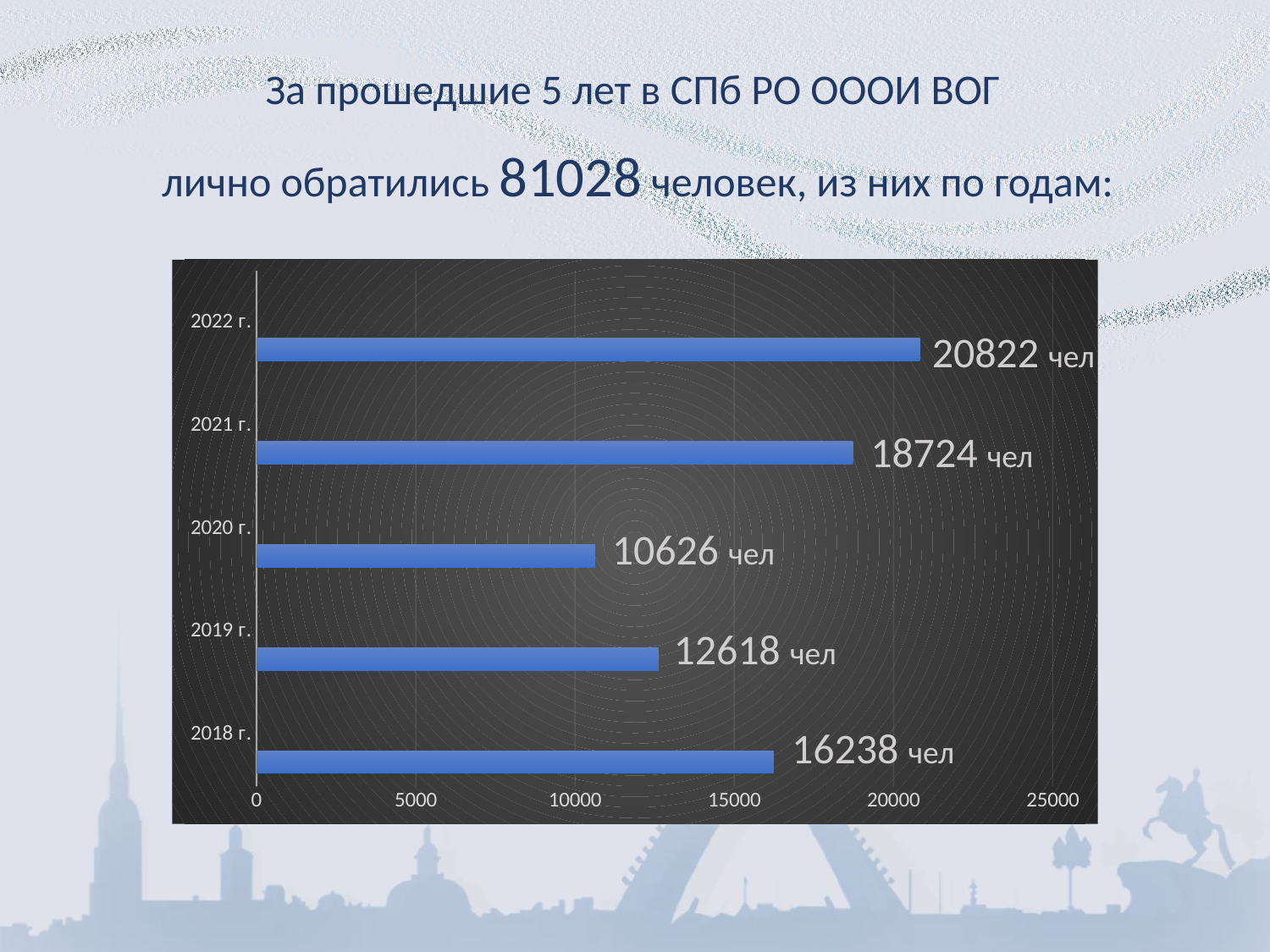
What is the difference between the values for 2022 г. and 2021 г.? 2098 What value is shown for 2020 г.? 10626 чел What is the highest value shown on the horizontal axis? 25000 What is the difference between the values for 2018 г. and 2019 г.? 3620 Which year has the highest value? 2022 г. Which is larger, the value for 2019 г. or the value for 2018 г.? 2018 г. What value is shown for 2022 г.? 20822 чел What kind of chart is shown on the slide? bar chart Is the value for 2021 г. greater or less than 15000? greater How many years are shown in the chart? 5 What value is shown for 2018 г.? 16238 чел Which year has the lowest value? 2020 г.